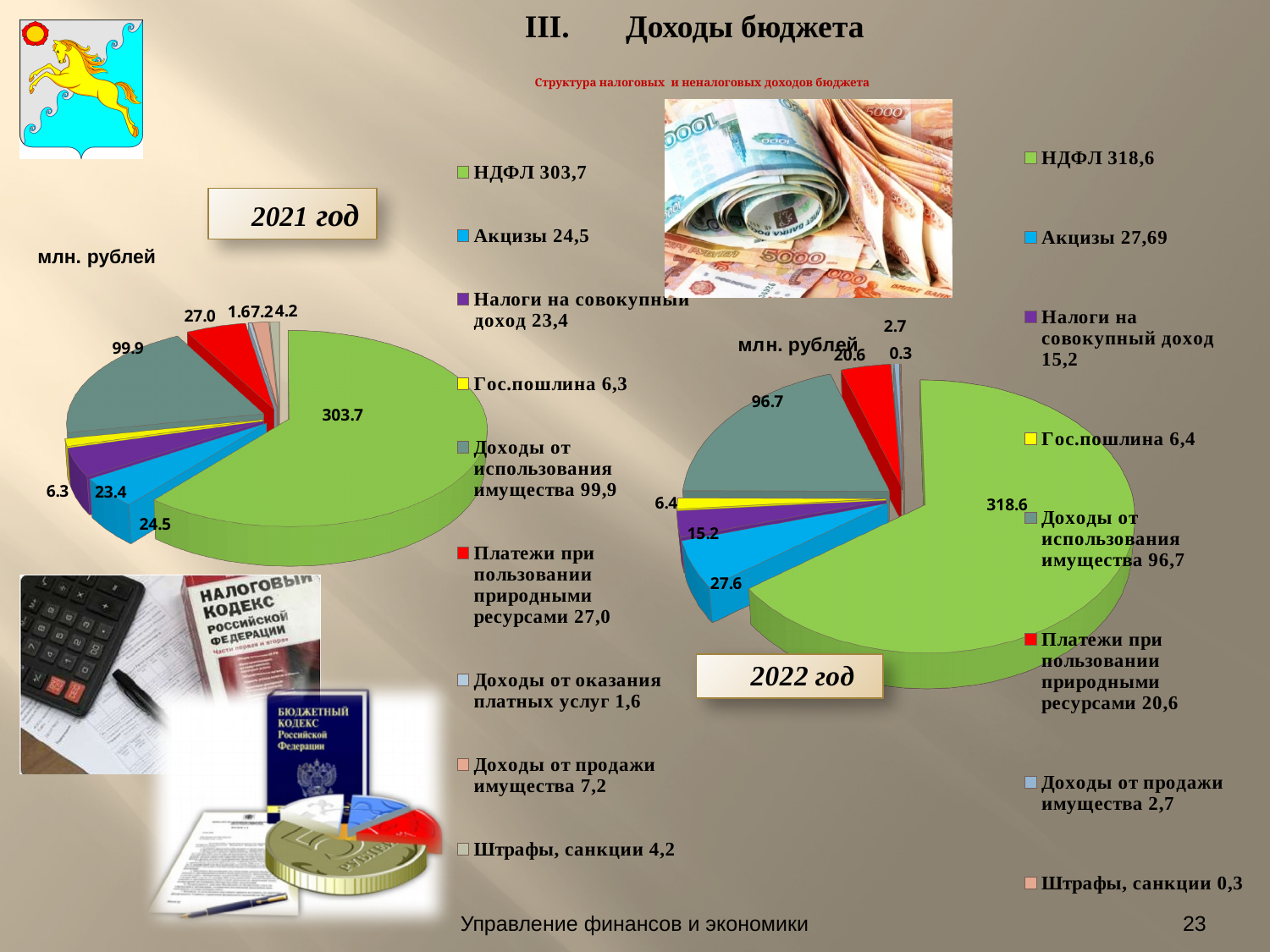
In the 2022 pie chart, which category has the smallest slice? Штрафы, санкции In the 2021 pie chart, which is larger: Акцизы or Налоги на совокупный доход? Акцизы In the 2021 pie chart, what is the value for НДФЛ? 303.7 In the 2022 pie chart, what is the value for Налоги на совокупный доход? 15.2 In the 2021 pie chart, which category has the smallest slice? Доходы от оказания платных услуг What type of chart is used to show the 2021 budget revenue structure? Pie chart In the 2022 pie chart, what is the value for Доходы от использования имущества? 96.7 In the 2021 pie chart, what is the value for Платежи при пользовании природными ресурсами? 27.0 How many categories does the 2021 pie chart legend list? 9 What is the difference between the НДФЛ value in the 2022 chart and the НДФЛ value in the 2021 chart? 14.9 How many categories does the 2022 pie chart legend list? 8 In the 2021 pie chart, which category has the largest slice? НДФЛ